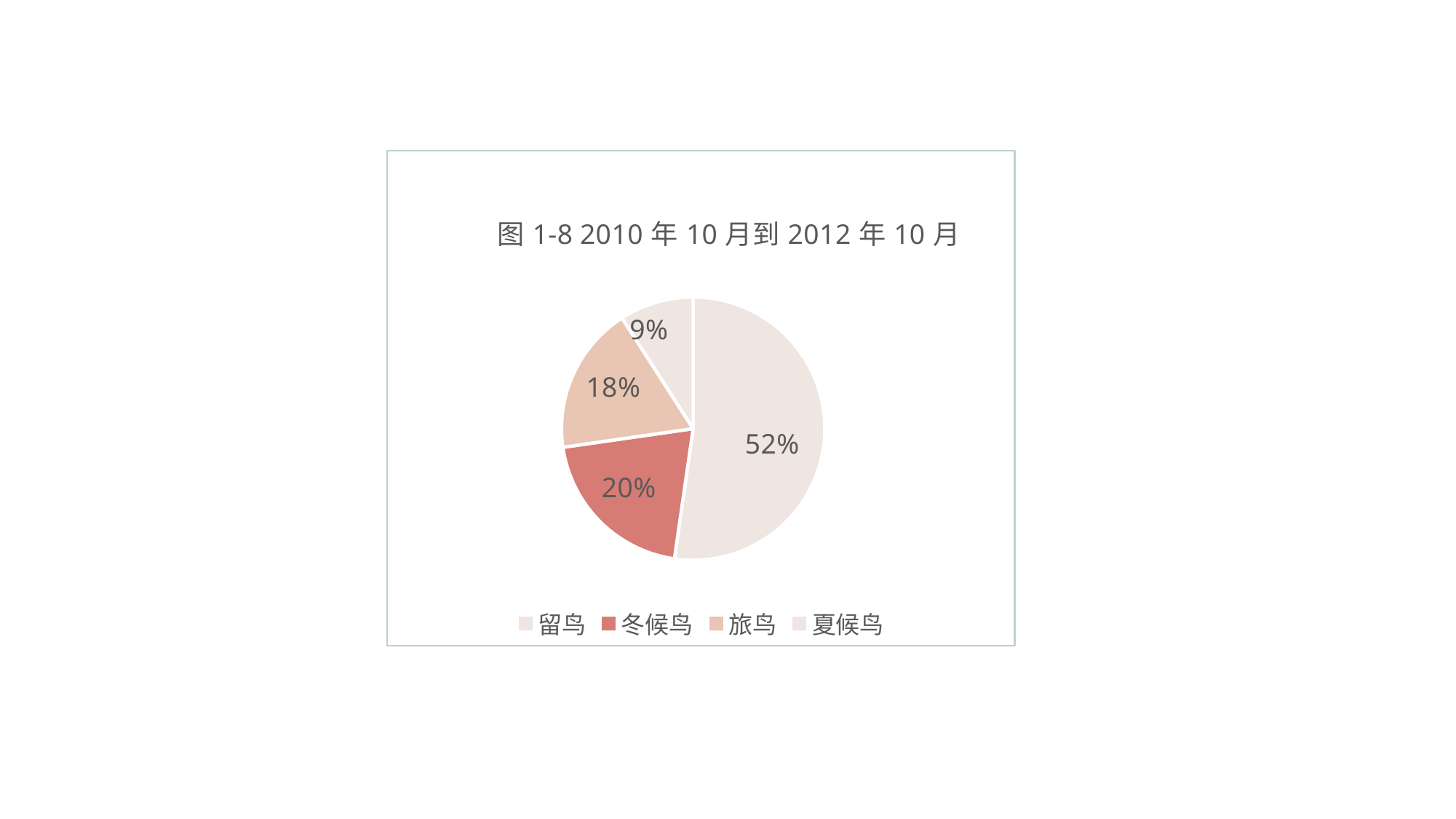
What is the title of the chart? 图 1-8 2010 年 10 月到 2012 年 10 月 Which is larger, the share for 旅鸟 or the share for 夏候鸟? 旅鸟 What kind of chart is shown on the slide? Pie chart What share of the pie does 夏候鸟 take? 9% What is the difference in percentage points between 留鸟 and 冬候鸟? 32 Which category has the smallest slice of the pie? 夏候鸟 What share of the pie does 留鸟 take? 52% How many entries does the legend list? 4 How many slices does the pie chart have? 4 What share of the pie does 旅鸟 take? 18% Which category has the largest slice of the pie? 留鸟